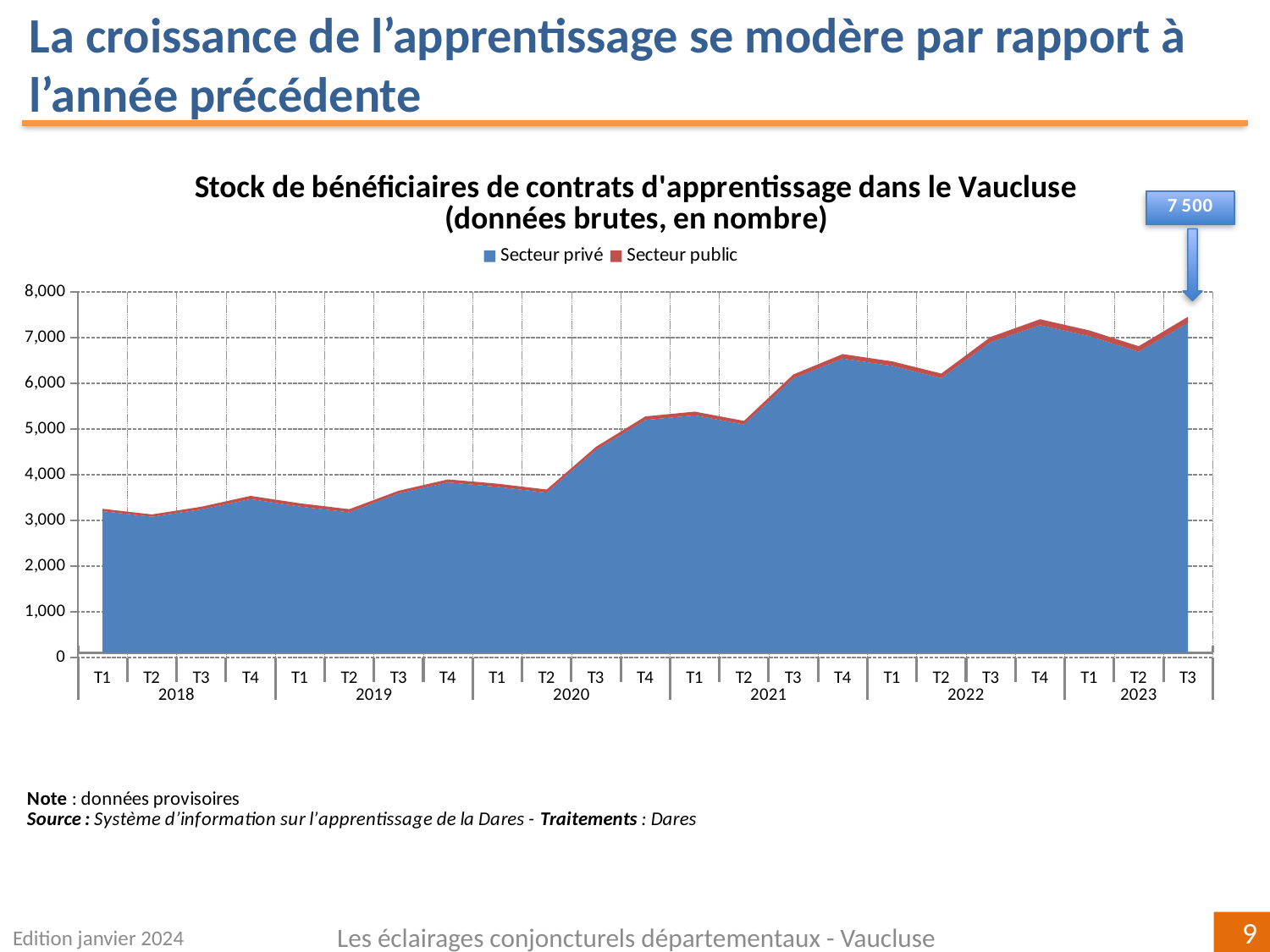
How many series does the legend list? 2 Overall, does the stock of apprenticeship beneficiaries rise or fall from 2018 to 2023? Rise What are the two series named in the legend? Secteur privé and Secteur public Which is larger, the total for T4 2022 or the total for T2 2023? T4 2022 Is the total value for T2 2023 greater or less than 7,000? less What kind of chart is shown on the slide? Area chart How many quarters are plotted on the x axis? 23 What is the total stock of apprenticeship beneficiaries shown for T3 2023? 7 500 Is the total value for T4 2020 greater or less than 5,000? greater Is the total value for T4 2021 greater or less than 6,000? greater In which quarter is the total stock of apprenticeship beneficiaries highest? T3 2023